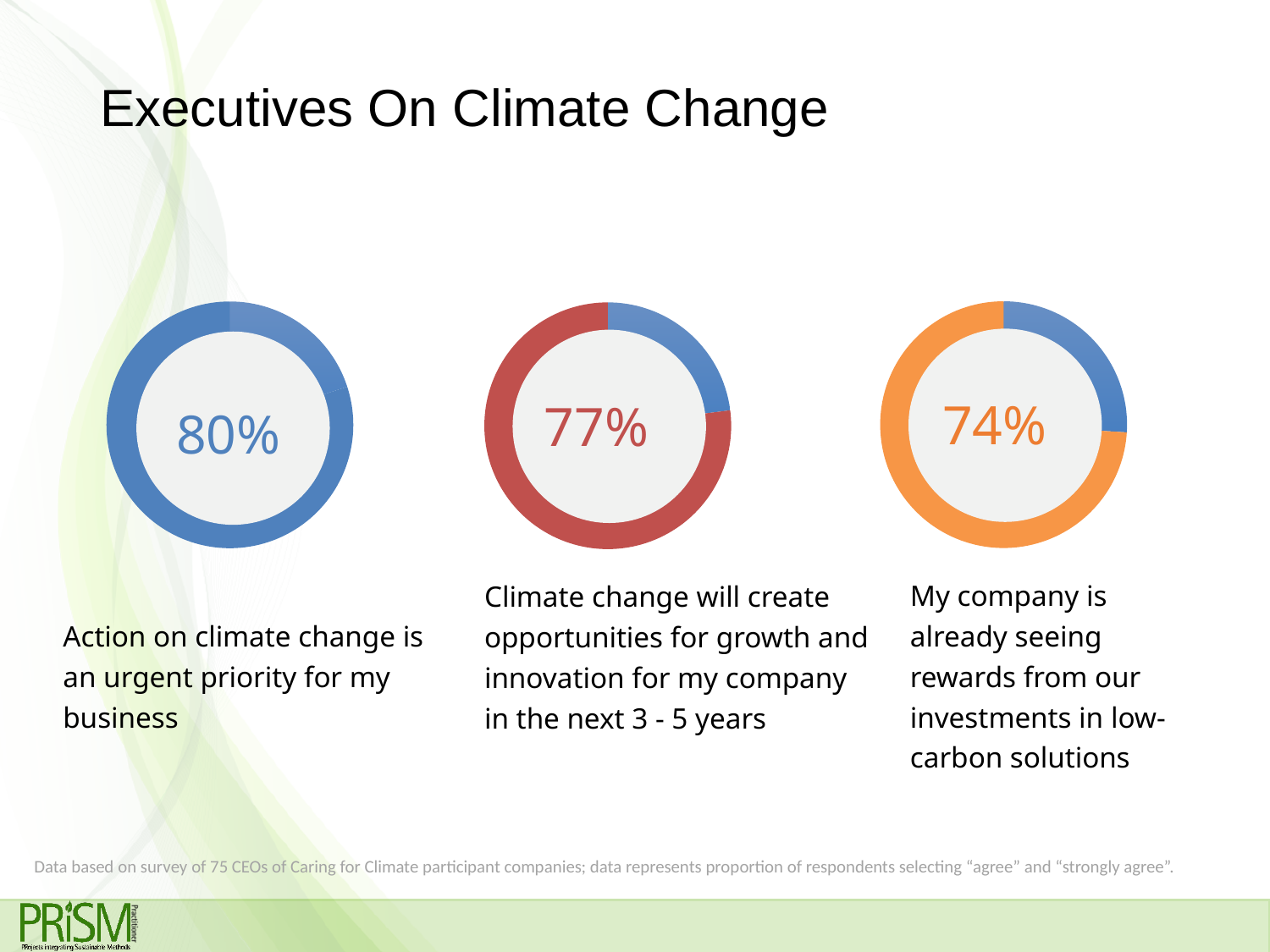
On the left chart, what percentage of executives agree that action on climate change is an urgent priority for their business? 80% What colour is the filled portion of the middle chart's ring? Red What is the title of the slide containing the three charts? Executives On Climate Change Which is larger: the value on the middle chart or the value on the right chart? The middle chart (77%) What is the difference in percentage points between the left chart and the middle chart? 3 percentage points On the right chart, what percentage say their company is already seeing rewards from investments in low-carbon solutions? 74% What is the difference in percentage points between the left chart (80%) and the right chart (74%)? 6 percentage points What kind of chart is used to display each percentage on the slide? Donut (pie) chart On the middle chart, what percentage agree that climate change will create opportunities for growth and innovation for their company in the next 3 - 5 years? 77% Across the three charts, which statement has the lowest percentage of agreement? My company is already seeing rewards from our investments in low-carbon solutions Across the three charts, which statement has the highest percentage of agreement? Action on climate change is an urgent priority for my business How many donut charts are shown on the slide? 3